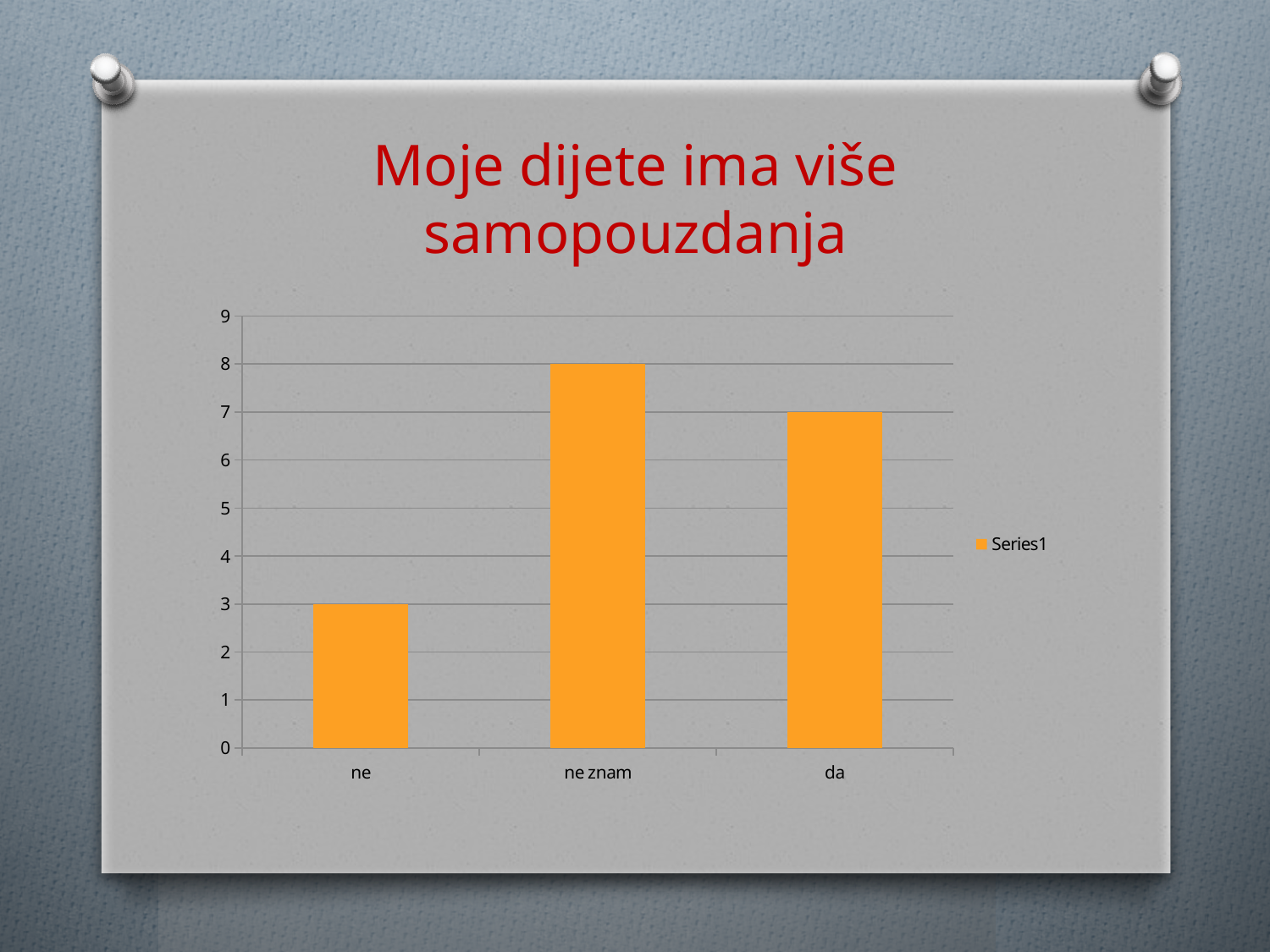
What is the value for "da"? 7 What kind of chart is shown on the slide? bar chart Which is larger, the value for "da" or the value for "ne"? da Which category has the lowest value? ne Is the value for "ne" greater or less than 5? less What is the value for "ne znam"? 8 What is the difference between the values for "da" and "ne"? 4 What is the title of the slide? Moje dijete ima više samopouzdanja What is the difference between the values for "ne znam" and "ne"? 5 What is the value for "ne"? 3 Which category has the highest value? ne znam How many categories are shown on the x axis? 3